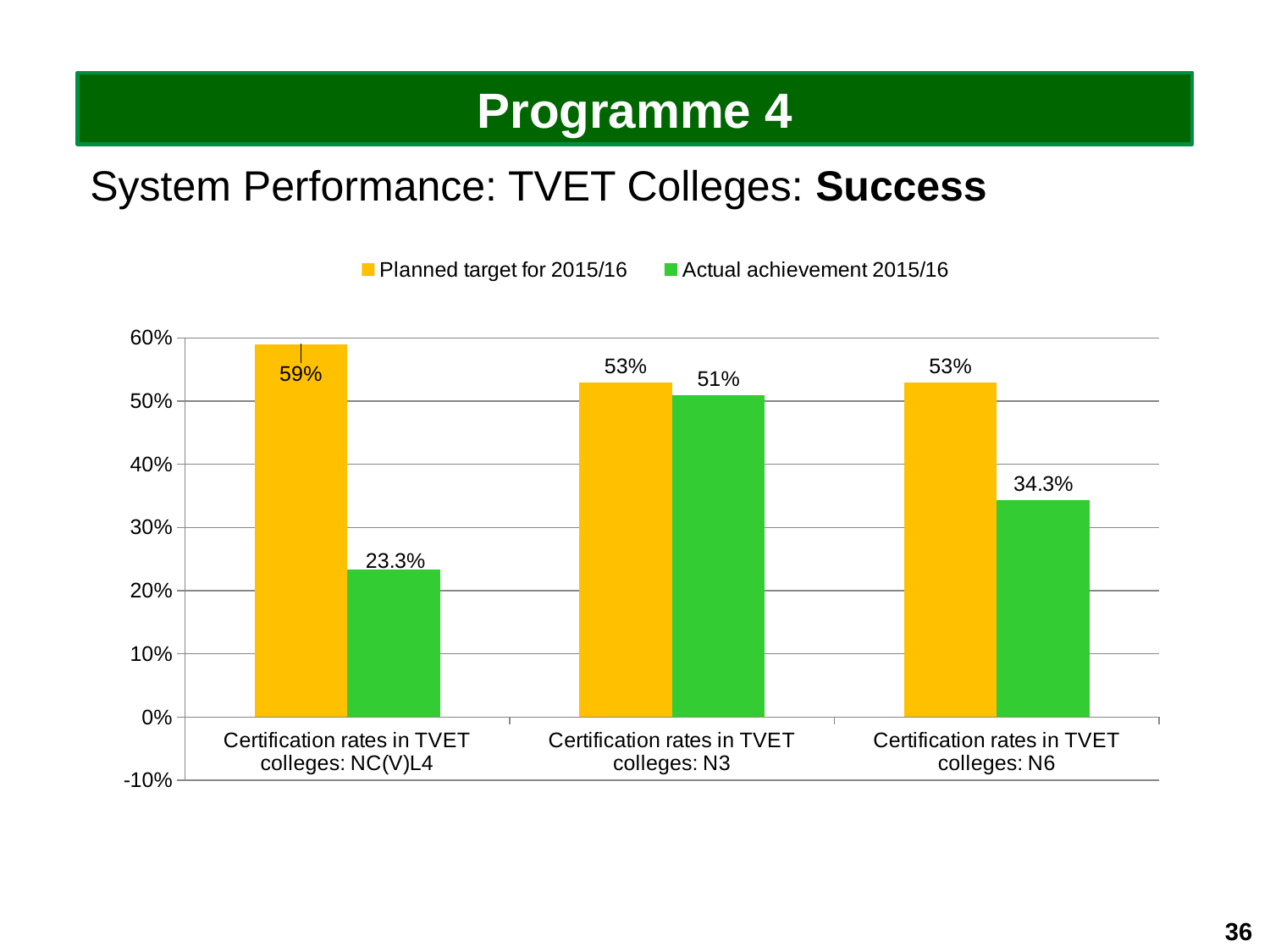
Which category has the highest planned target for 2015/16? Certification rates in TVET colleges: NC(V)L4 How many categories are shown on the x axis? 3 How many series does the legend list? 2 What is the planned target for 2015/16 for certification rates in TVET colleges: N6? 53% What kind of chart is shown on the slide? Bar chart Which category has the lowest actual achievement 2015/16? Certification rates in TVET colleges: NC(V)L4 What is the actual achievement 2015/16 for certification rates in TVET colleges: N6? 34.3% What is the planned target for 2015/16 for certification rates in TVET colleges: NC(V)L4? 59% What is the difference between the planned target and the actual achievement for certification rates in TVET colleges: N6? 18.7% Which is larger for certification rates in TVET colleges: N3, the planned target for 2015/16 or the actual achievement 2015/16? Planned target for 2015/16 What is the actual achievement 2015/16 for certification rates in TVET colleges: NC(V)L4? 23.3% What is the actual achievement 2015/16 for certification rates in TVET colleges: N3? 51%